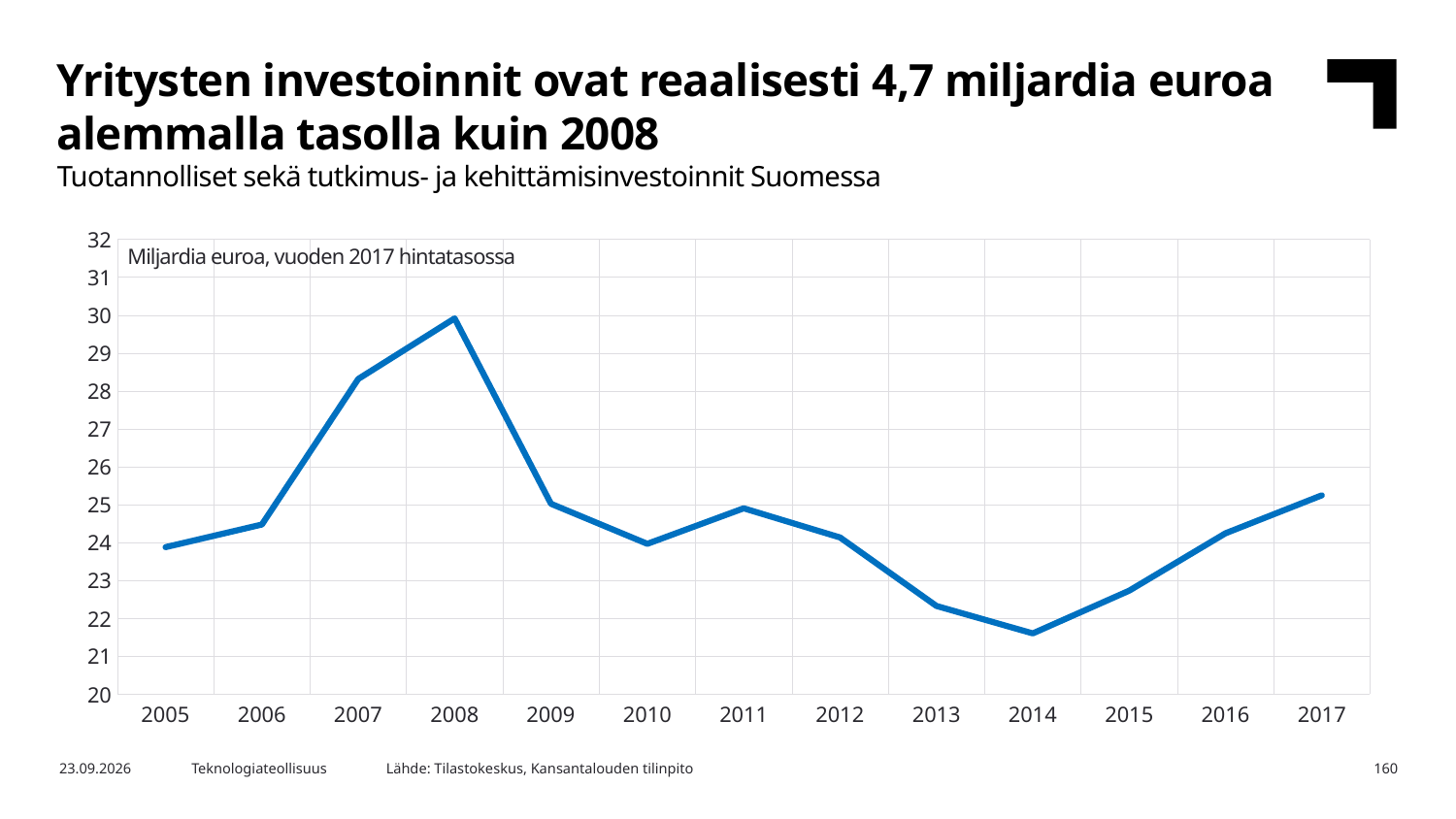
Is the value for 2008 greater or less than 29? greater In which year does the line reach its lowest value? 2014 Is the value for 2014 greater or less than 22? less What unit is stated in the label inside the chart area? Miljardia euroa, vuoden 2017 hintatasossa How many years are plotted on the x axis? 13 What kind of chart is shown on the slide? Line chart Is the value for 2007 greater or less than 27? greater Which year has the larger value, 2011 or 2013? 2011 In which year does the line reach its highest value? 2008 Which year has the larger value, 2007 or 2017? 2007 Do the values rise or fall from 2008 to 2014? fall